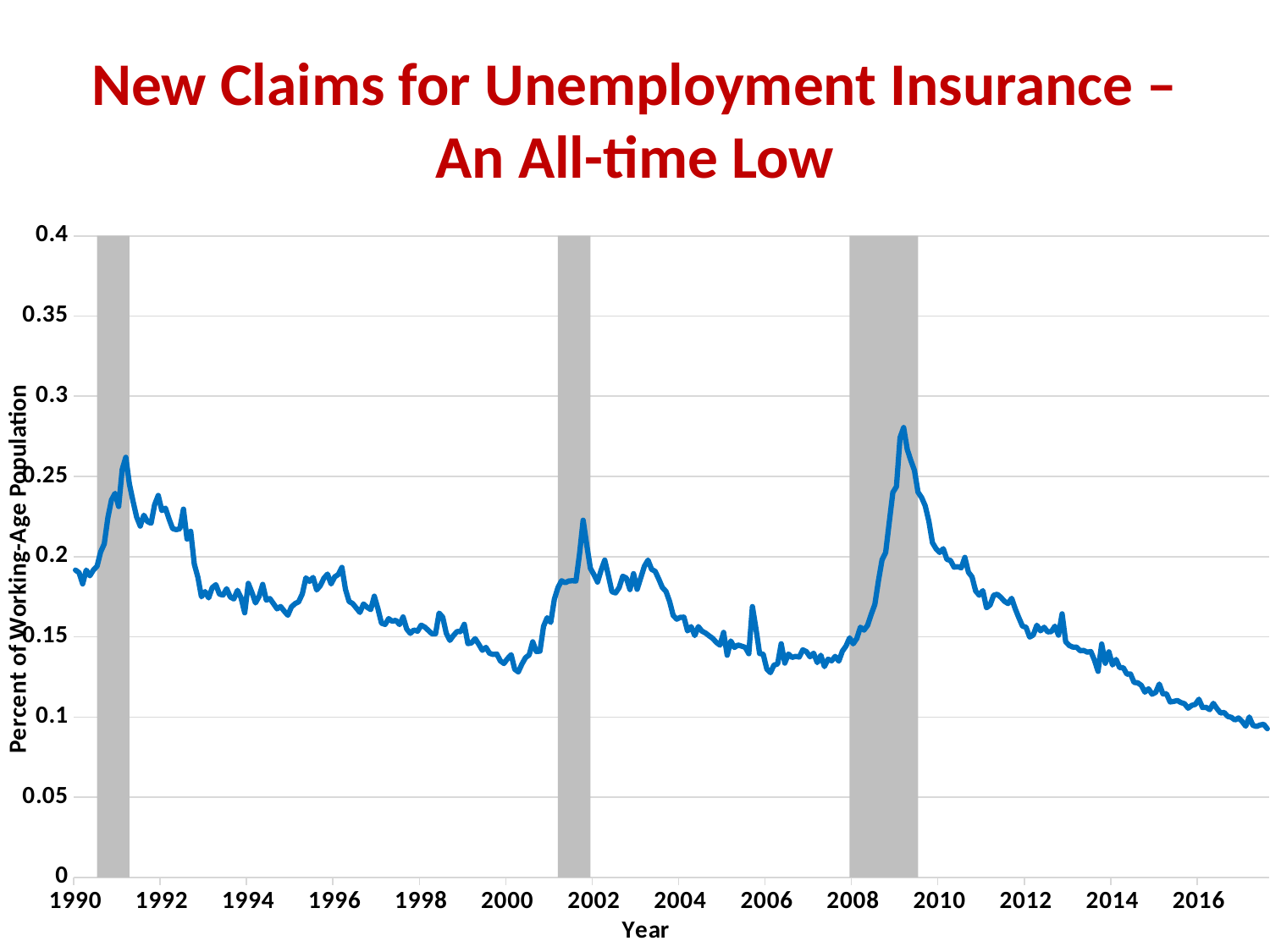
What is the title of the chart on the slide? New Claims for Unemployment Insurance – An All-time Low Around which year does the line reach its lowest value? 2017 Is the value of the line in 1990 greater or less than 0.15? greater Is the value of the line at its 1991 peak greater or less than 0.3? less What kind of chart is shown on the slide? line chart Is the value of the line in 2016 greater or less than 0.15? less What is the label of the vertical axis? Percent of Working-Age Population Does the line rise or fall between 2007 and 2009? rise Around which year does the line reach its highest value? 2009 Does the line rise or fall between 2009 and 2017? fall